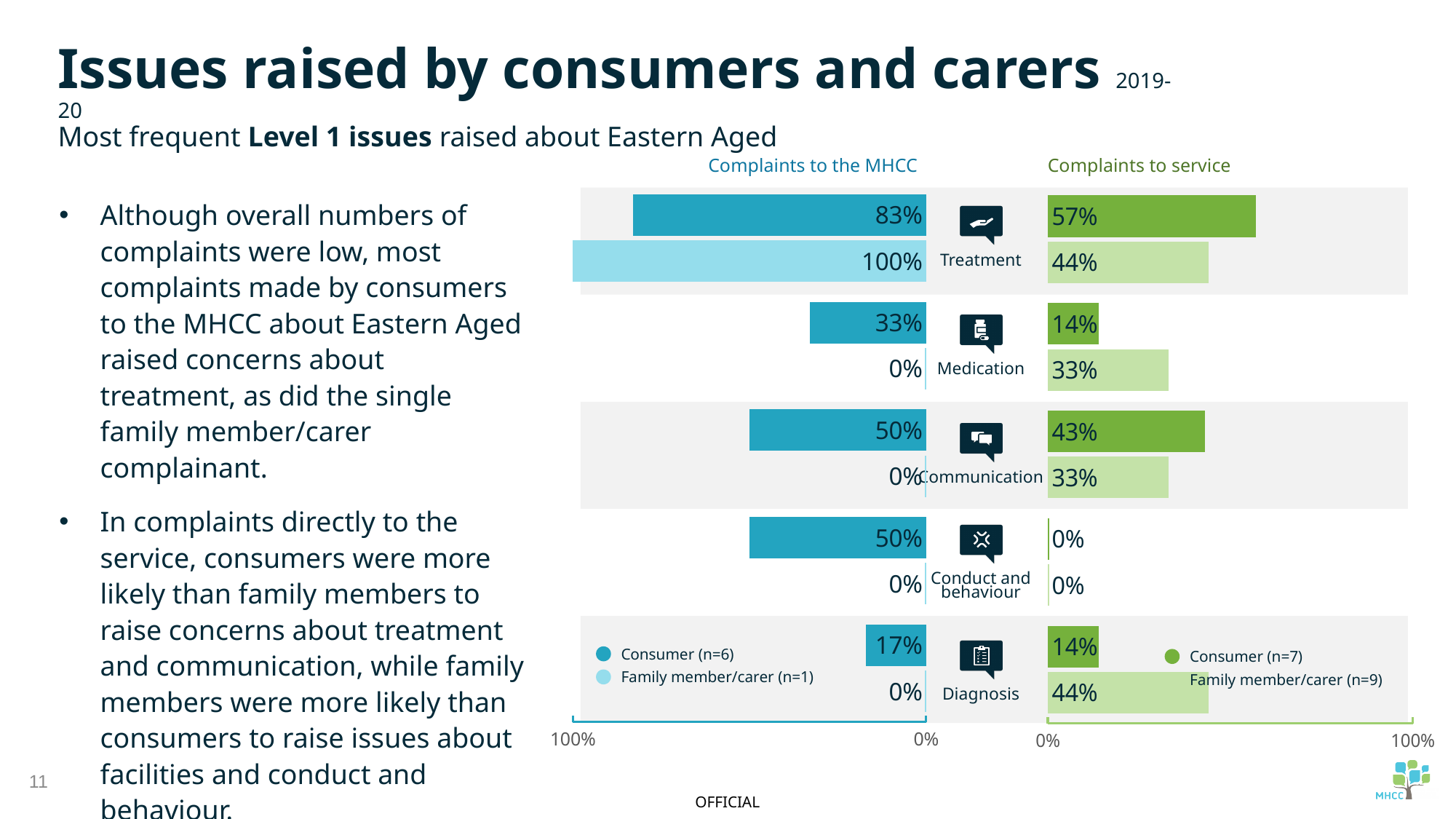
In the 'Complaints to service' chart, what is the difference between the Consumer and Family member/carer values for Treatment? 13% In the 'Complaints to service' chart, what is the Consumer value for Communication? 43% What kind of chart is the 'Complaints to service' chart? Bar chart In the 'Complaints to the MHCC' chart, what sample size is given for Family member/carer in the legend? n=1 In the 'Complaints to the MHCC' chart, which category has the lowest Consumer value? Diagnosis In the 'Complaints to service' chart, which is larger for Medication: the Consumer value or the Family member/carer value? Family member/carer In the 'Complaints to service' chart, what is the Family member/carer value for Diagnosis? 44% In the 'Complaints to the MHCC' chart, what is the Family member/carer value for Treatment? 100% In the 'Complaints to the MHCC' chart, what is the Consumer value for Treatment? 83% How many series does the legend of the 'Complaints to service' chart list? 2 How many categories are shown in the 'Complaints to the MHCC' chart? 5 In the 'Complaints to the MHCC' chart, which category has the highest Consumer value? Treatment